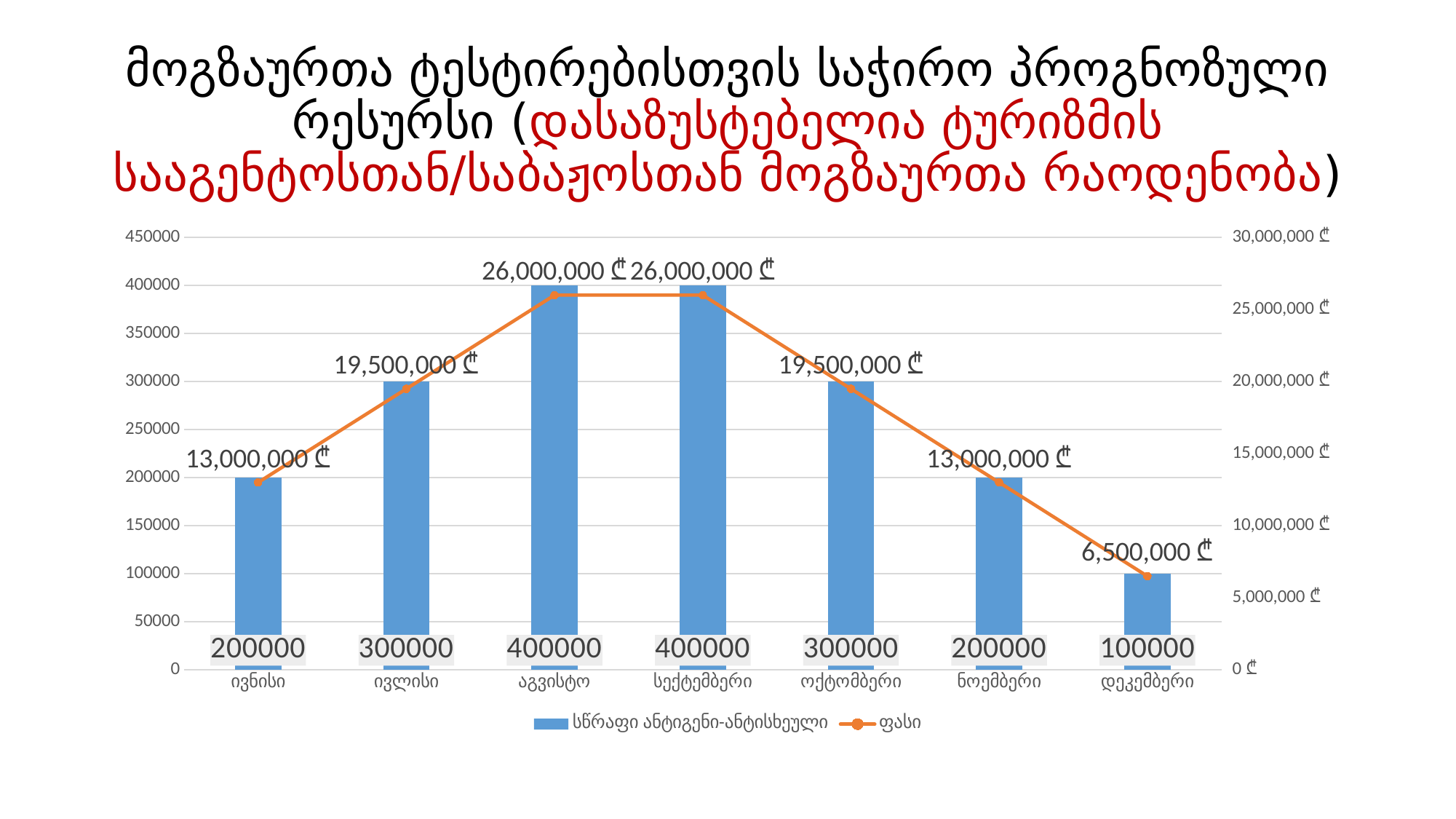
Which category has the lowest სწრაფი ანტიგენი-ანტისხეული bar? დეკემბერი What is the ფასი value for დეკემბერი? 6,500,000 ₾ What kind of chart is shown on the slide? Combined bar and line chart How many categories are shown on the x axis? 7 What is the ფასი value for ოქტომბერი? 19,500,000 ₾ What is the value of the სწრაფი ანტიგენი-ანტისხეული bar for ივლისი? 300000 What is the highest ფასი value shown on the chart? 26,000,000 ₾ How does the ფასი line change from სექტემბერი to დეკემბერი? It falls What is the difference between the ფასი values for ივლისი and ნოემბერი? 6,500,000 ₾ How many series does the legend list? 2 What is the difference between the სწრაფი ანტიგენი-ანტისხეული values for აგვისტო and ივნისი? 200000 Which has a larger სწრაფი ანტიგენი-ანტისხეული value, ივნისი or ოქტომბერი? ოქტომბერი